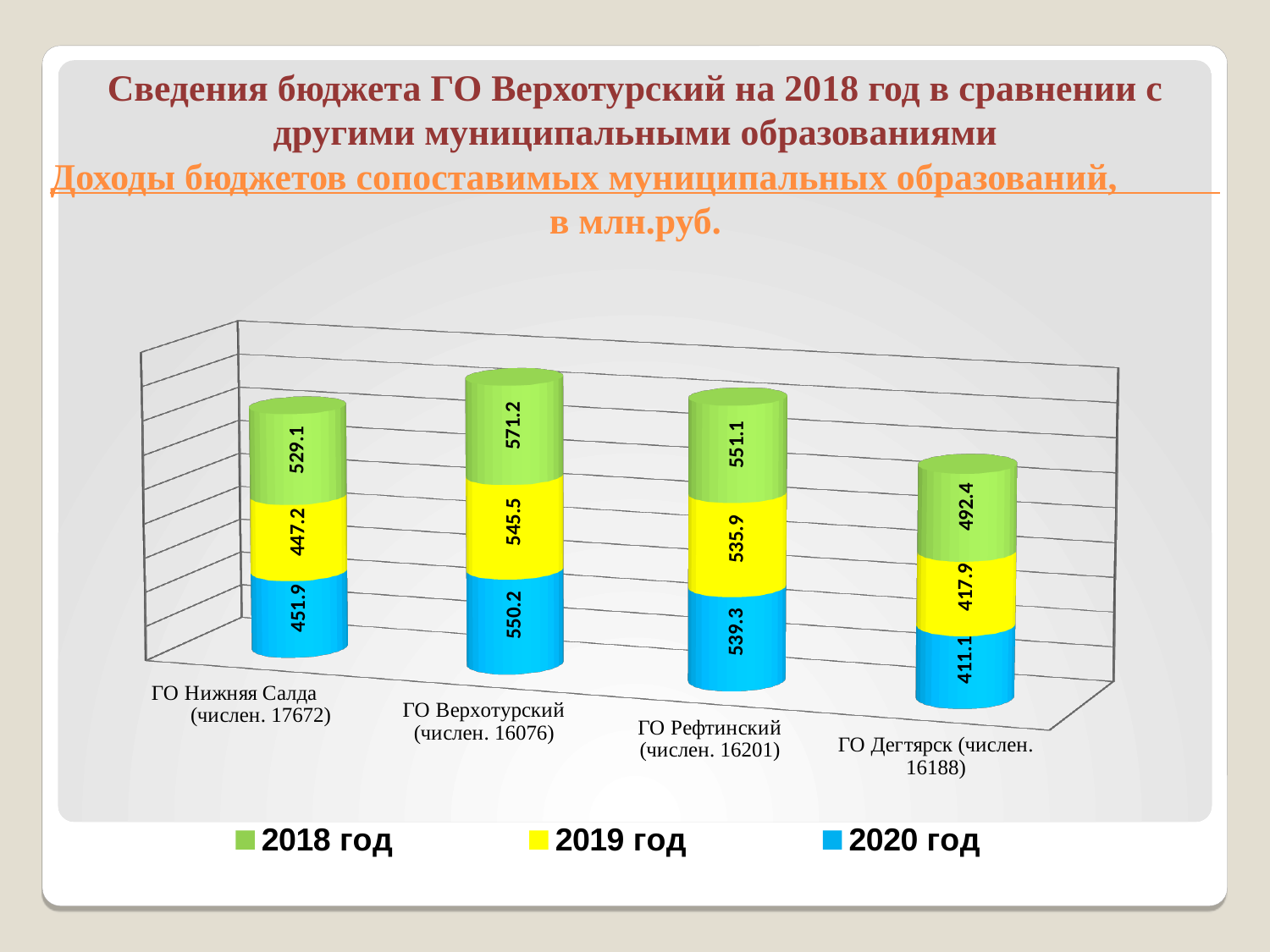
Which municipality has the highest 2018 год value? ГО Верхотурский What is the difference between the 2018 год values for ГО Верхотурский and ГО Нижняя Салда? 42.1 Which municipality has the lowest 2020 год value? ГО Дегтярск What is the difference between the 2020 год values for ГО Верхотурский and ГО Дегтярск? 139.1 How many series does the legend list? 3 What is the total of the stacked bar for ГО Дегтярск? 1321.4 What is the 2018 год value for ГО Верхотурский? 571.2 How many municipalities are shown on the chart? 4 What kind of chart is shown on the slide? Stacked bar chart What is the 2020 год value for ГО Дегтярск? 411.1 What is the 2019 год value for ГО Нижняя Салда? 447.2 Which is larger: the 2019 год value for ГО Рефтинский or the 2019 год value for ГО Дегтярск? ГО Рефтинский